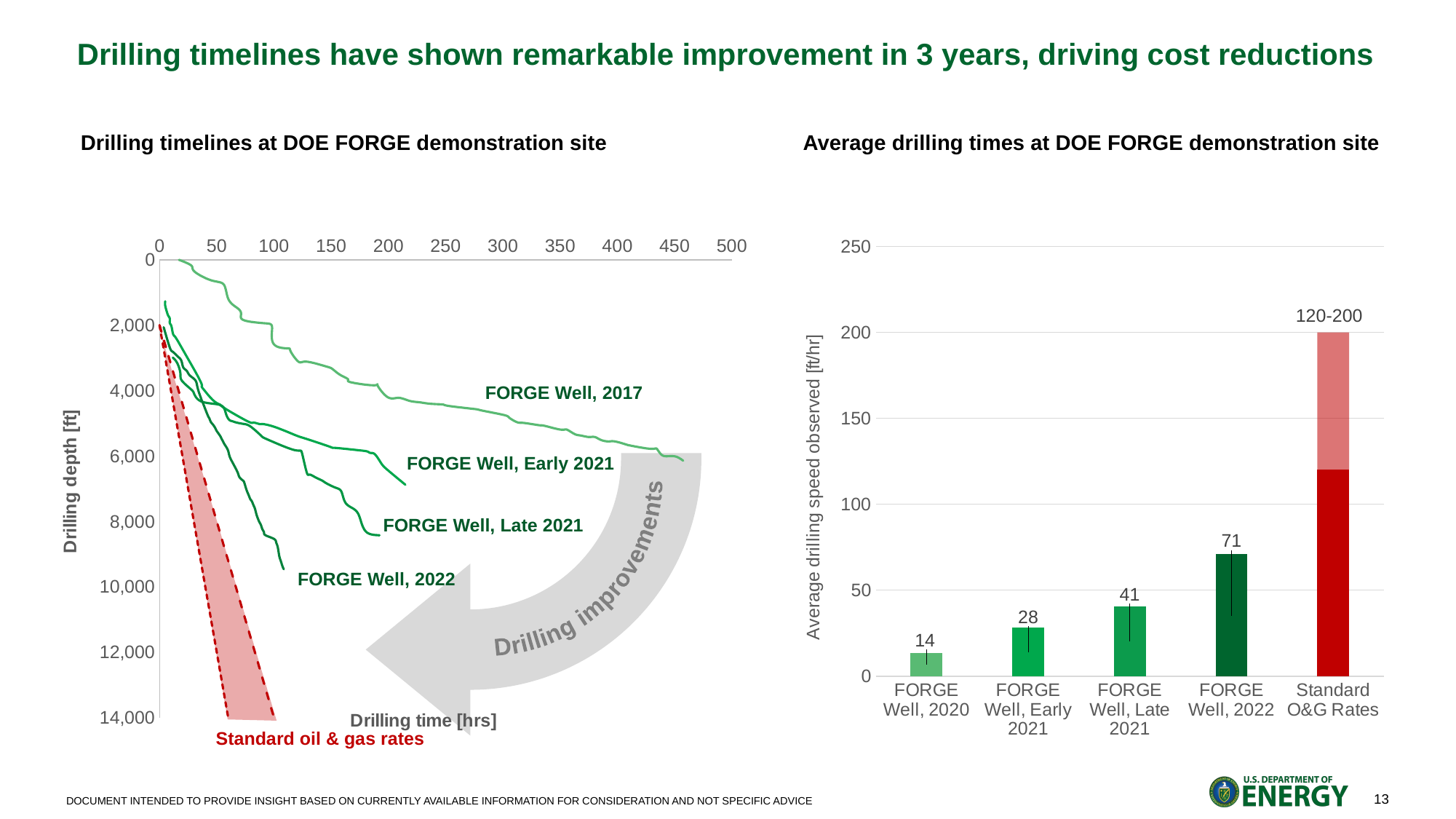
What kind of chart is 'Drilling timelines at DOE FORGE demonstration site'? Line chart In the 'Average drilling times at DOE FORGE demonstration site' chart, what is the average drilling speed for FORGE Well, 2022? 71 In the 'Average drilling times at DOE FORGE demonstration site' chart, what value is labelled for Standard O&G Rates? 120-200 In the 'Average drilling times at DOE FORGE demonstration site' chart, which is larger: FORGE Well, Early 2021 or FORGE Well, Late 2021? FORGE Well, Late 2021 In the 'Drilling timelines at DOE FORGE demonstration site' chart, is the total drilling time for FORGE Well, 2017 greater or less than 400 hours? greater In the 'Average drilling times at DOE FORGE demonstration site' chart, do the values for the FORGE wells rise or fall from 2020 to 2022? Rise What is the y-axis label of the 'Drilling timelines at DOE FORGE demonstration site' chart? Drilling depth [ft] In the 'Average drilling times at DOE FORGE demonstration site' chart, what is the value for FORGE Well, 2020? 14 What kind of chart is 'Average drilling times at DOE FORGE demonstration site'? Bar chart How many categories are shown in the 'Average drilling times at DOE FORGE demonstration site' chart? 5 In the 'Average drilling times at DOE FORGE demonstration site' chart, what is the difference between FORGE Well, 2022 and FORGE Well, Late 2021? 30 In the 'Average drilling times at DOE FORGE demonstration site' chart, which category has the lowest value? FORGE Well, 2020